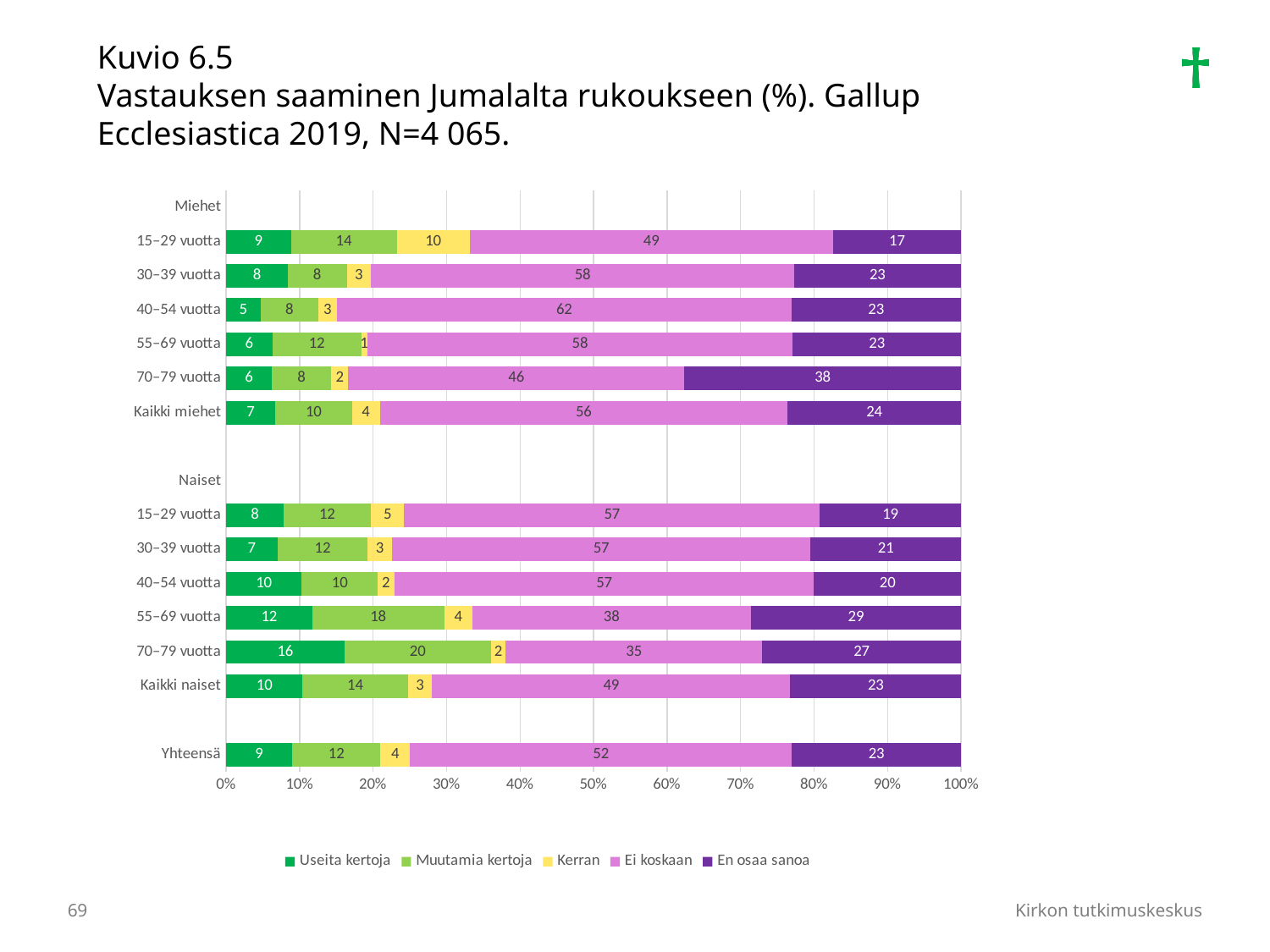
What kind of chart is shown on the slide? Stacked bar chart How many series does the legend list? 5 Which bar has the highest value for "Ei koskaan"? Miehet 40–54 vuotta Which bar has the lowest value for "Kerran"? Miehet 55–69 vuotta What is the value of "Ei koskaan" for men (Miehet) aged 40–54 vuotta? 62 Which bar has the highest value for "Useita kertoja"? Naiset 70–79 vuotta What is the value of "Ei koskaan" for the Yhteensä bar? 52 For the 55–69 vuotta age group, is the "Muutamia kertoja" value larger for men (Miehet) or women (Naiset)? Naiset What is the difference between the "Ei koskaan" values for Kaikki miehet and Kaikki naiset? 7 What is the value of "En osaa sanoa" for men (Miehet) aged 70–79 vuotta? 38 What is the value of "Useita kertoja" for women (Naiset) aged 70–79 vuotta? 16 Which series is shown in yellow in the legend? Kerran